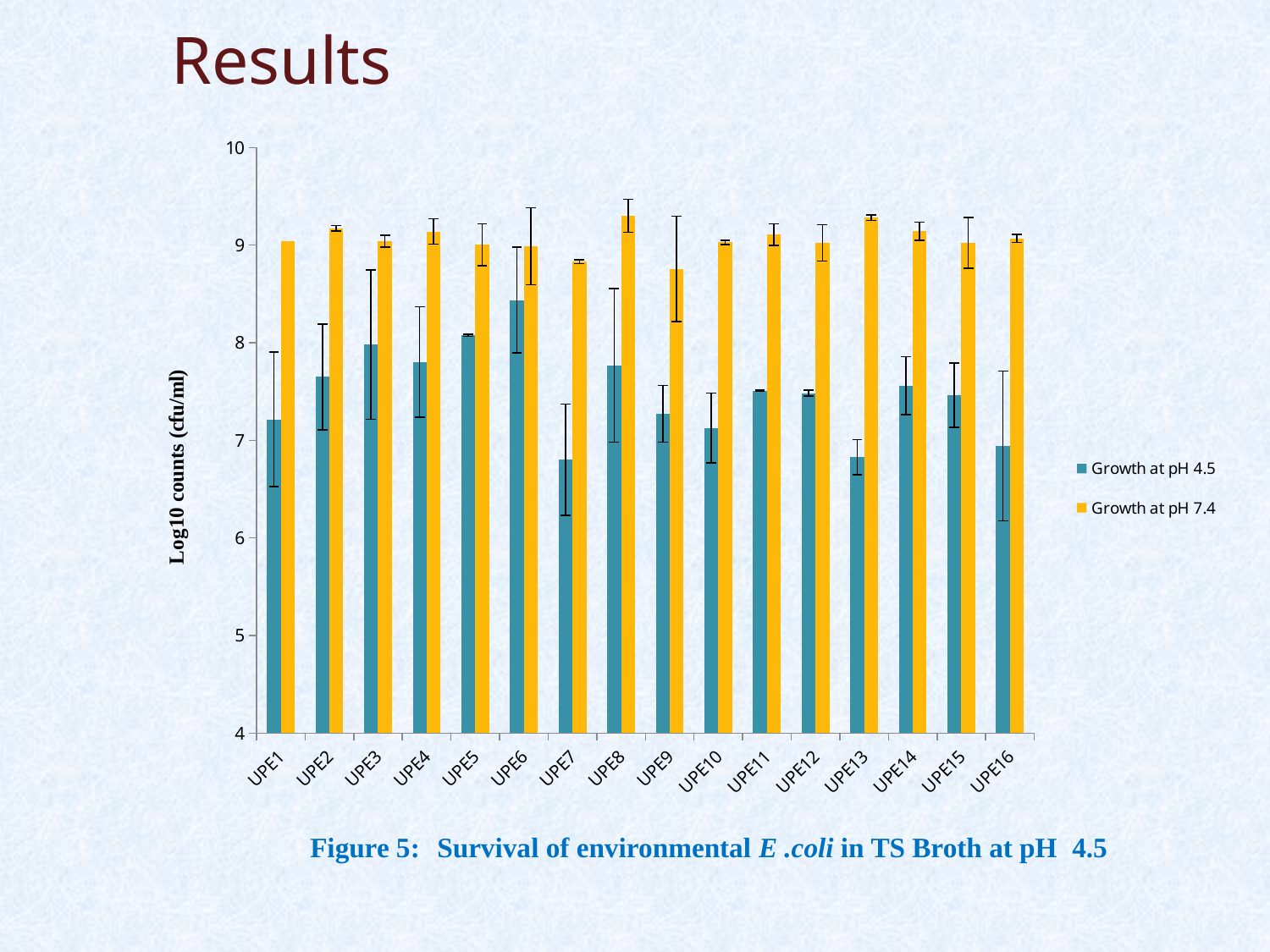
For Growth at pH 4.5, which is larger: UPE6 or UPE7? UPE6 How many series does the legend list? 2 Which isolate has the highest value for Growth at pH 4.5? UPE6 Is the value for UPE9 at Growth at pH 7.4 greater or less than 9? less For UPE1, which series has the larger value: Growth at pH 4.5 or Growth at pH 7.4? Growth at pH 7.4 Is the value for UPE8 at Growth at pH 7.4 greater or less than 9? greater Is the value for UPE7 at Growth at pH 4.5 greater or less than 7? less How many isolates (categories) are shown along the x axis? 16 What kind of chart is shown on the slide? Bar chart What is the label on the y axis? Log10 counts (cfu/ml)